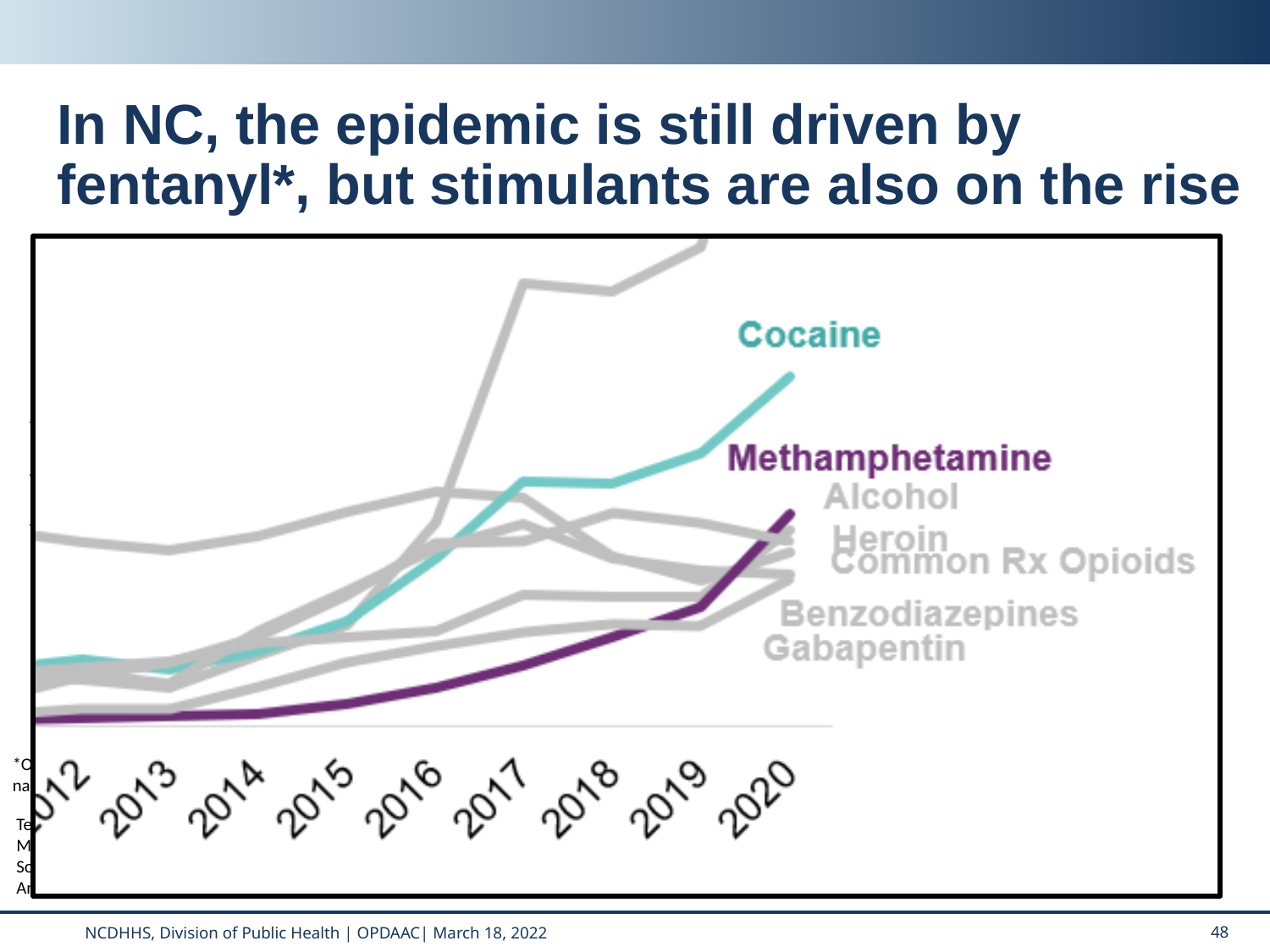
Does the Methamphetamine line rise or fall from 2012 to 2020? rise What is the last year shown on the x axis? 2020 How many years are labeled on the x axis of the chart? 9 Does the Cocaine line rise or fall from 2012 to 2020? rise What kind of chart is shown on the slide? line chart What is the first year shown on the x axis? 2012 How many named series are labeled on the chart? 7 Which is higher in 2020, Cocaine or Methamphetamine? Cocaine Is the Cocaine value higher in 2019 or in 2020? 2020 Is the Cocaine value higher in 2015 or in 2017? 2017 Which labeled series has the lowest value in 2012? Methamphetamine